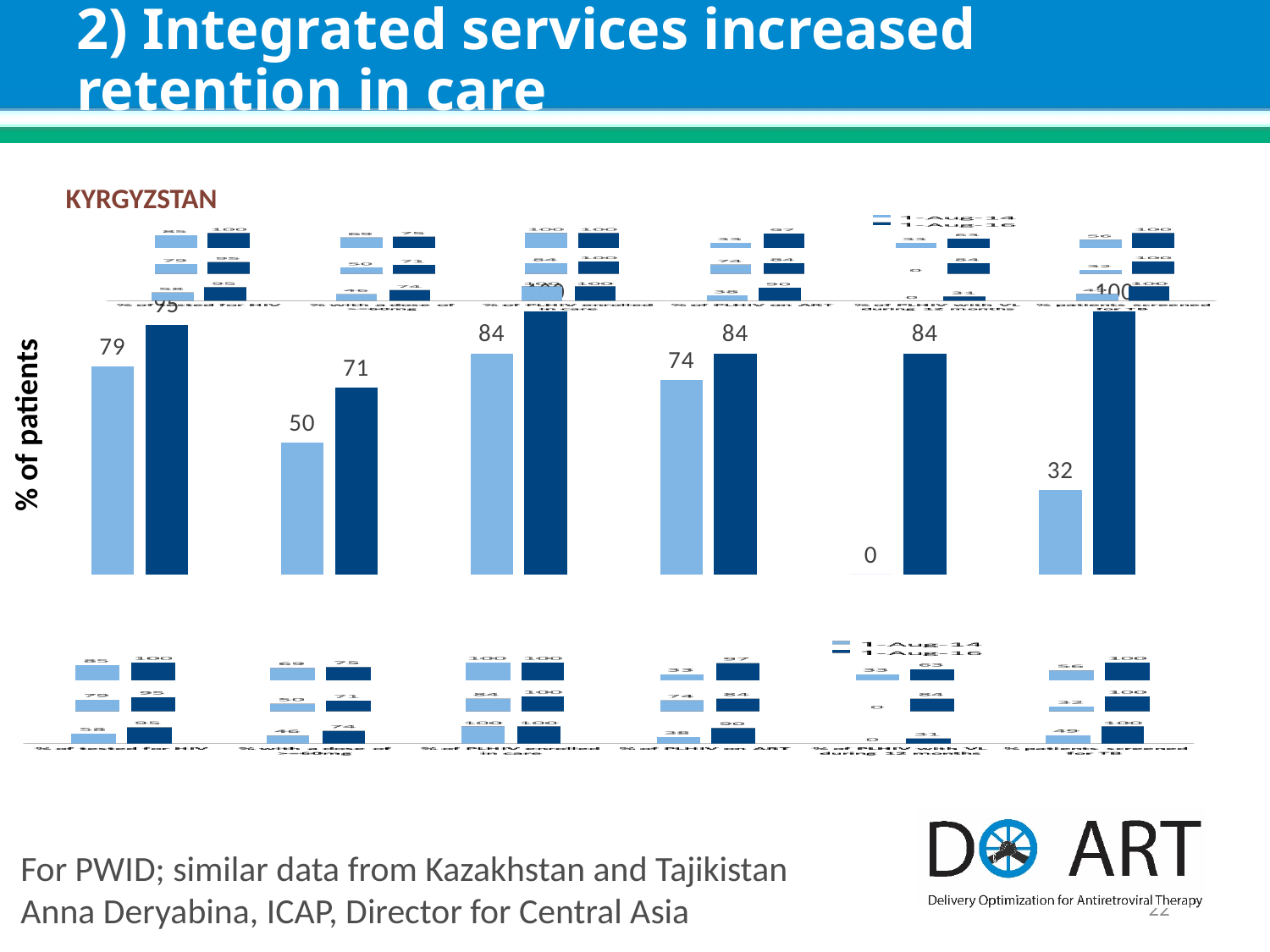
What is the difference between the dark blue and light blue bars in the second group? 21 What kind of chart is shown on the slide? bar chart What is the value of the dark blue bar in the fifth group of bars? 84 Which is larger, the light blue bar in the first group or the light blue bar in the second group? the first group What is the value of the light blue bar in the sixth (rightmost) group of bars? 32 What is the value of the light blue bar in the second group of bars? 50 What is the difference between the dark blue and light blue bars in the fourth group? 10 What is the value of the dark blue bar in the second group of bars? 71 How many groups of bars does the chart show? 6 Which group has the lowest light blue bar? the fifth group (0) What is the value of the light blue bar in the first group of bars? 79 What is the value of the light blue bar in the fourth group of bars? 74